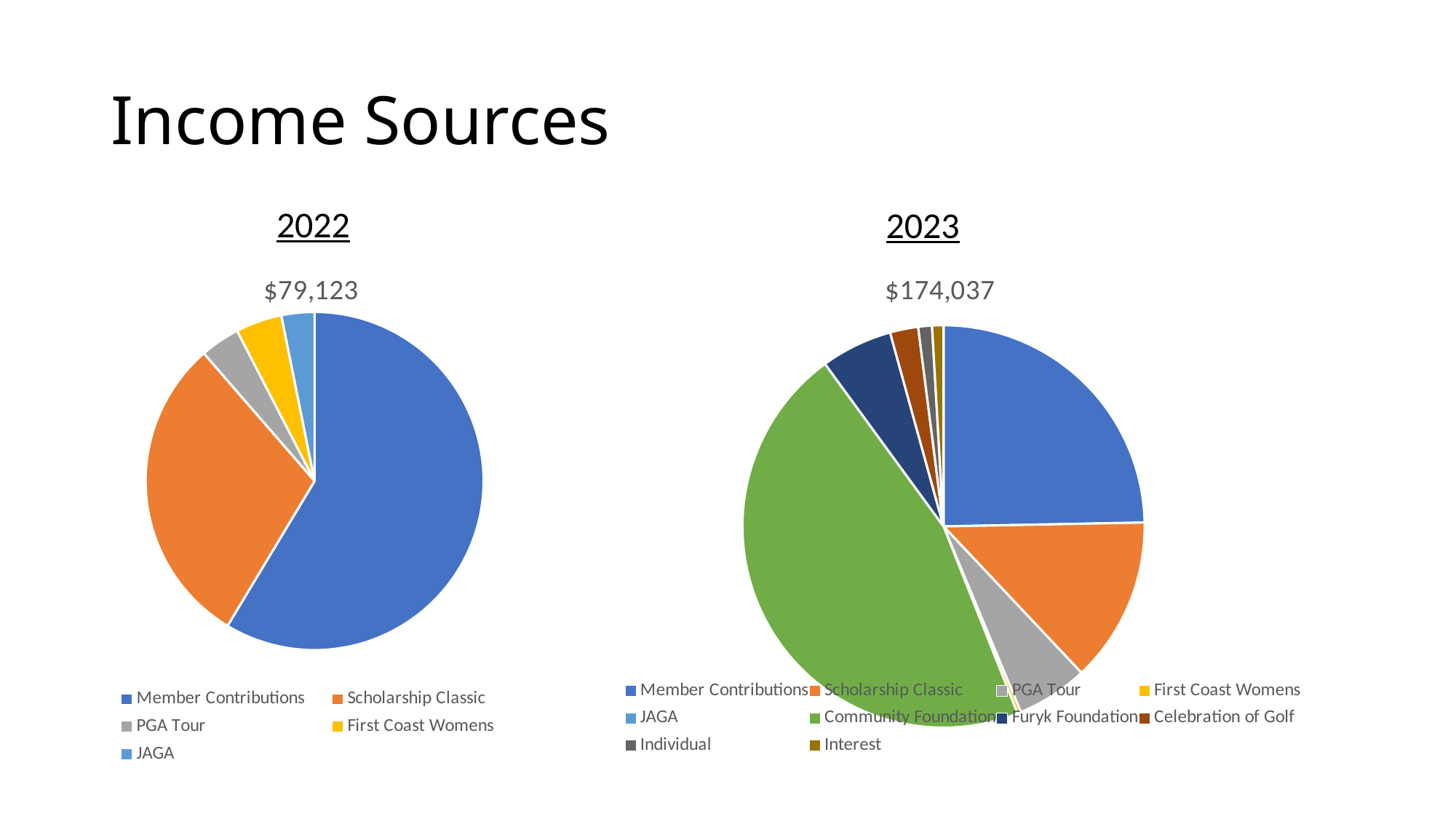
What is the title of the slide containing the two pie charts? Income Sources What kind of chart is the 2022 chart? pie chart What total amount is shown above the 2022 pie chart? $79,123 In the 2023 chart, which is larger: Community Foundation or Member Contributions? Community Foundation How many categories does the legend of the 2022 chart list? 5 In the 2022 chart, which is larger: Member Contributions or Scholarship Classic? Member Contributions What kind of chart is the 2023 chart? pie chart In the 2022 chart, which income source has the largest slice? Member Contributions What total amount is shown above the 2023 pie chart? $174,037 In the 2023 chart, which income source has the largest slice? Community Foundation In the 2023 chart, which is larger: Scholarship Classic or PGA Tour? Scholarship Classic How many categories does the legend of the 2023 chart list? 10